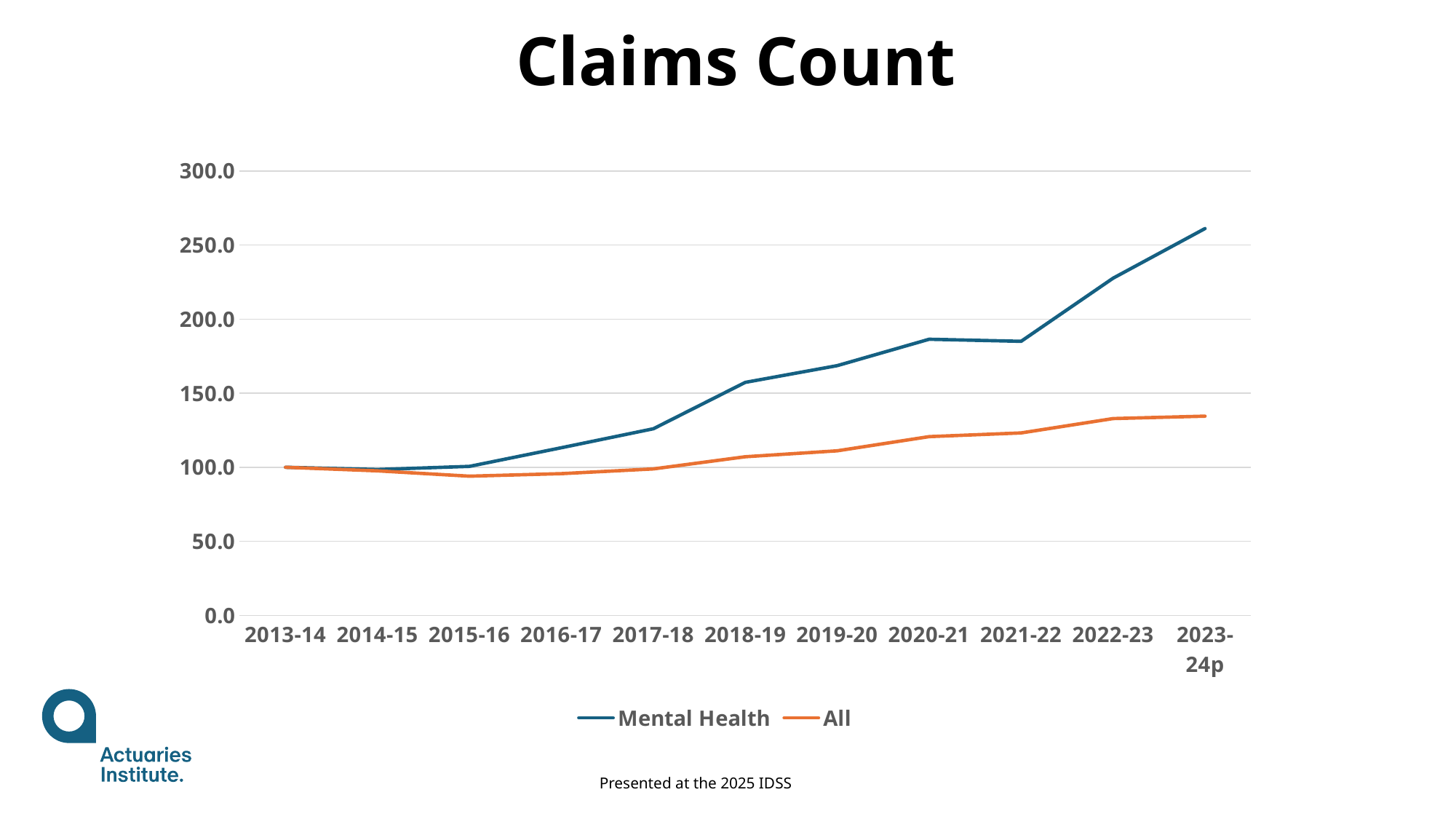
Does the Mental Health series generally rise or fall from 2013-14 to 2023-24p? Rise Which series has the larger value in 2023-24p, Mental Health or All? Mental Health Is the value for Mental Health in 2020-21 greater or less than 200? less What is the title of the chart? Claims Count How many time periods are shown on the x axis? 11 What is the value for All in 2013-14? 100.0 Is the value for All in 2023-24p greater or less than 150? less What is the value for Mental Health in 2013-14? 100.0 What kind of chart is shown on the slide? Line chart How many series does the legend list? 2 In which period does the Mental Health series reach its highest value? 2023-24p Is the value for Mental Health in 2023-24p greater or less than 250? greater